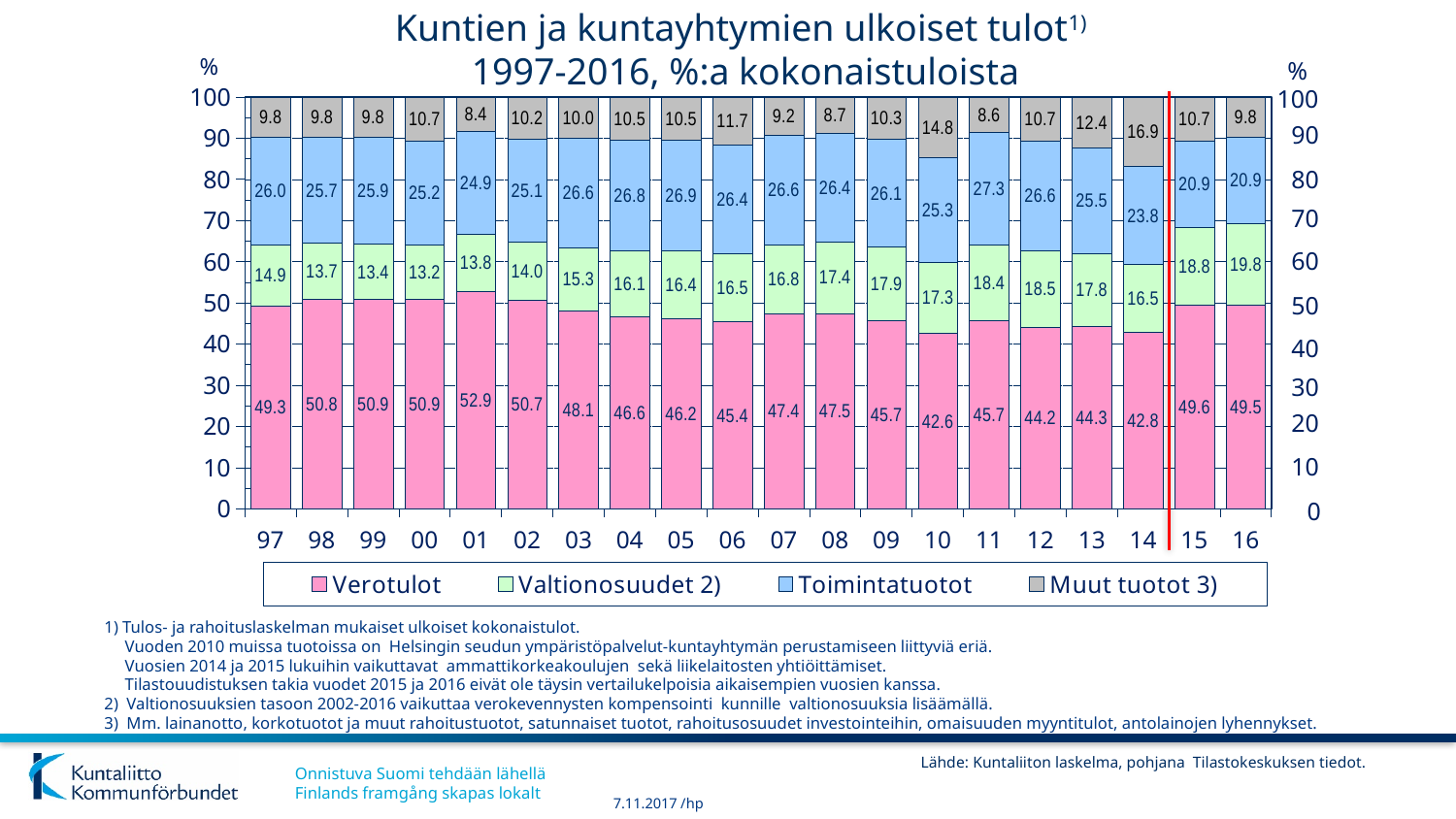
What is the Toimintatuotot value for 2011 (11)? 27.3 In which year is the Muut tuotot 3) share highest? 14 How many years are shown on the x axis? 20 How many series does the legend list? 4 What is the difference between the Verotulot value in 2001 (01) and in 2010 (10)? 10.3 What kind of chart is shown on the slide? Stacked bar chart Which is larger, the Toimintatuotot value in 2014 (14) or in 2015 (15)? 2014 (14) What is the Valtionosuudet 2) value for 2016 (16)? 19.8 What is the Muut tuotot 3) value for 2014 (14)? 16.9 What is the Verotulot value for 2001 (01)? 52.9 In which year is the Verotulot share highest? 01 In which year is the Verotulot share lowest? 10